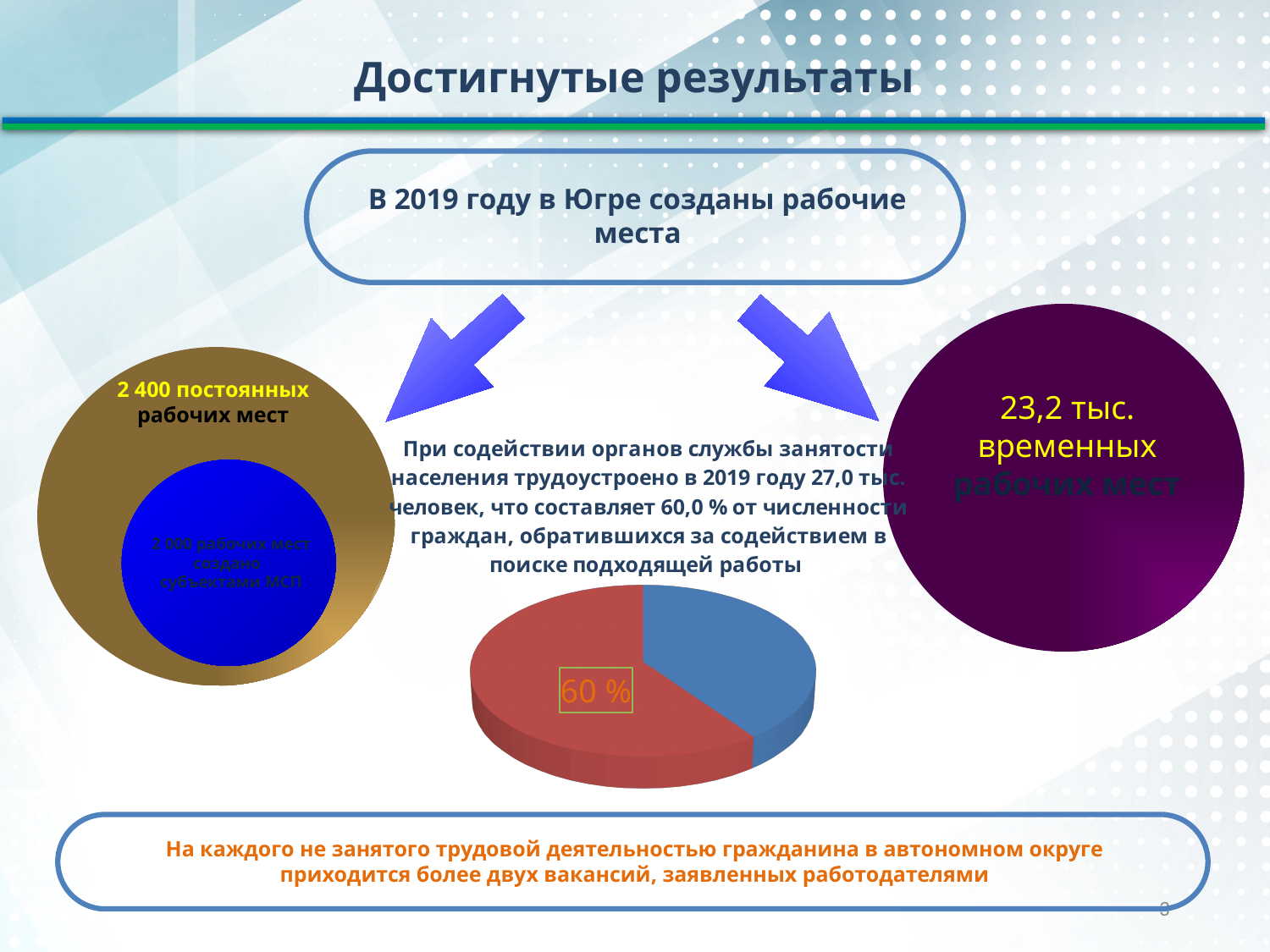
Which slice of the pie chart is larger, the red one or the blue one? the red one Which slice of the pie chart is the largest? the red slice (60 %) Which slice of the pie chart is the smallest? the blue slice What share of the pie does the red slice represent? 60 % What kind of chart is shown on the slide? pie chart How many slices does the pie chart have? 2 What colour is the slice of the pie chart that carries the 60 % label? red Does the pie chart display a legend? no What value is printed on the red slice of the pie chart? 60 %